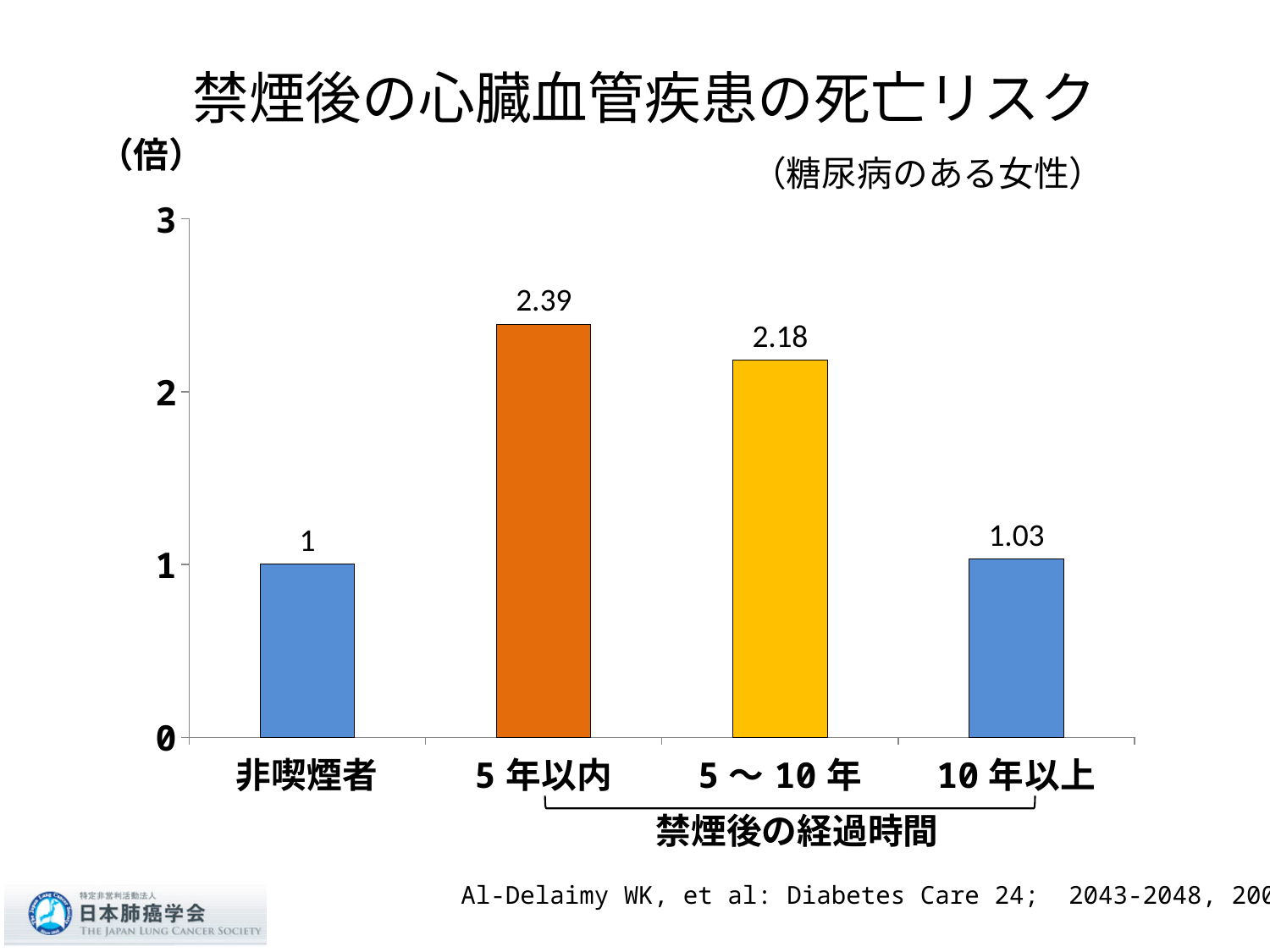
What is the value for 非喫煙者? 1 What is the value for 5～10年? 2.18 What is the title of the chart? 禁煙後の心臓血管疾患の死亡リスク What is the difference between the values for 5年以内 and 5～10年? 0.21 What is the difference between the values for 10年以上 and 非喫煙者? 0.03 What is the value for 10年以上? 1.03 How many categories are shown on the x axis? 4 Which category has the highest value? 5年以内 Which category has the lowest value? 非喫煙者 Which is larger, the value for 5年以内 or the value for 10年以上? 5年以内 What is the value for 5年以内? 2.39 What kind of chart is shown on the slide? bar chart